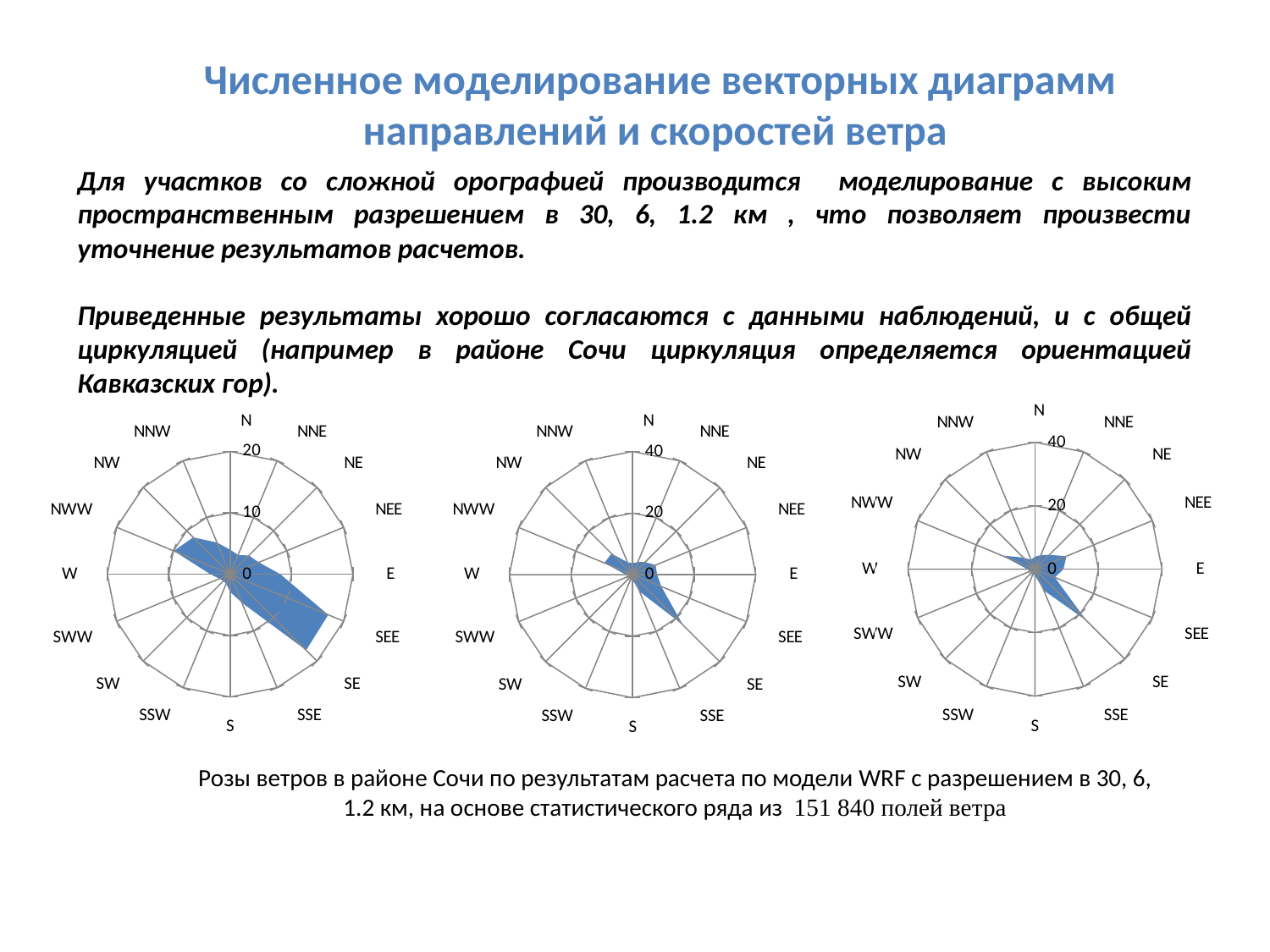
In the left chart, is the value for N greater or less than 10? less In the left chart, which is larger, the value for SE or the value for NE? SE How many wind-direction categories does the left chart plot? 16 In the middle chart, which direction has the highest value? SE In the middle chart, is the value for NW greater or less than 20? less How many wind-direction categories does the right chart plot? 16 What kind of chart is the left chart on the slide? radar chart In the right chart, is the value for W greater or less than 20? less In the right chart, which direction has the highest value? SE What is the largest tick value on the radial axis of the middle chart? 40